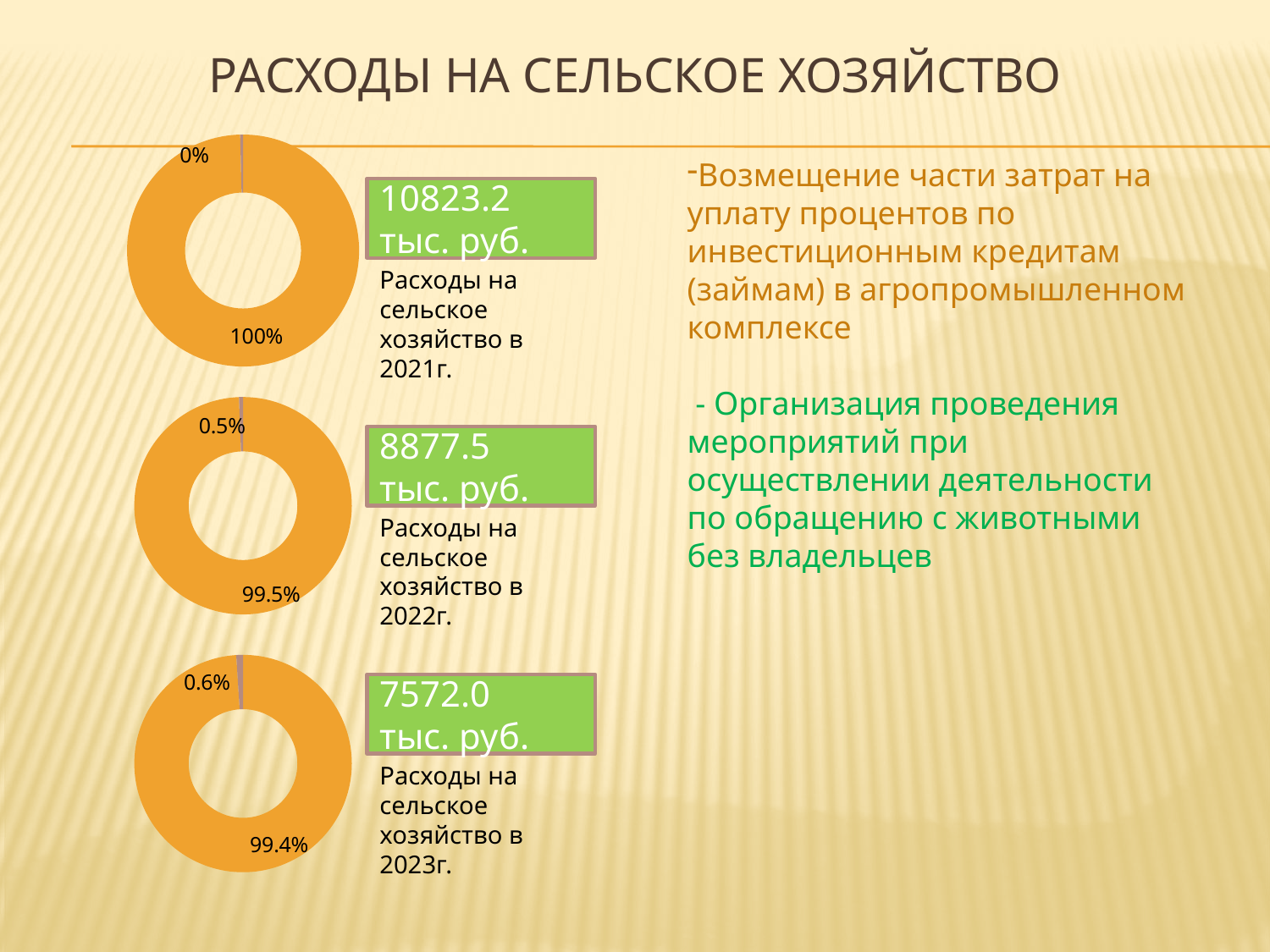
Which chart shows a larger share for its small slice: the middle chart (2022) or the bottom chart (2023)? the bottom chart (2023) In the top chart (2021), what percentage is shown for the large orange slice? 100% How many slices does each doughnut chart on the slide contain? 2 In the bottom chart (2023), what percentage is shown for the large orange slice? 99.4% In the middle chart (2022), what percentage is shown for the small slice? 0.5% What amount is shown in the green box next to the top chart (2021)? 10823.2 тыс. руб. What kind of chart is the top chart on the slide (next to the 2021 label)? doughnut chart In the bottom chart (2023), what percentage is shown for the small slice? 0.6% What is the difference between the large slice share in the middle chart (99.5%) and the large slice share in the bottom chart (99.4%)? 0.1% How many doughnut charts are shown on the slide? 3 In the middle chart (2022), what percentage is shown for the large orange slice? 99.5% In the top chart (2021), what percentage is shown for the small slice? 0%